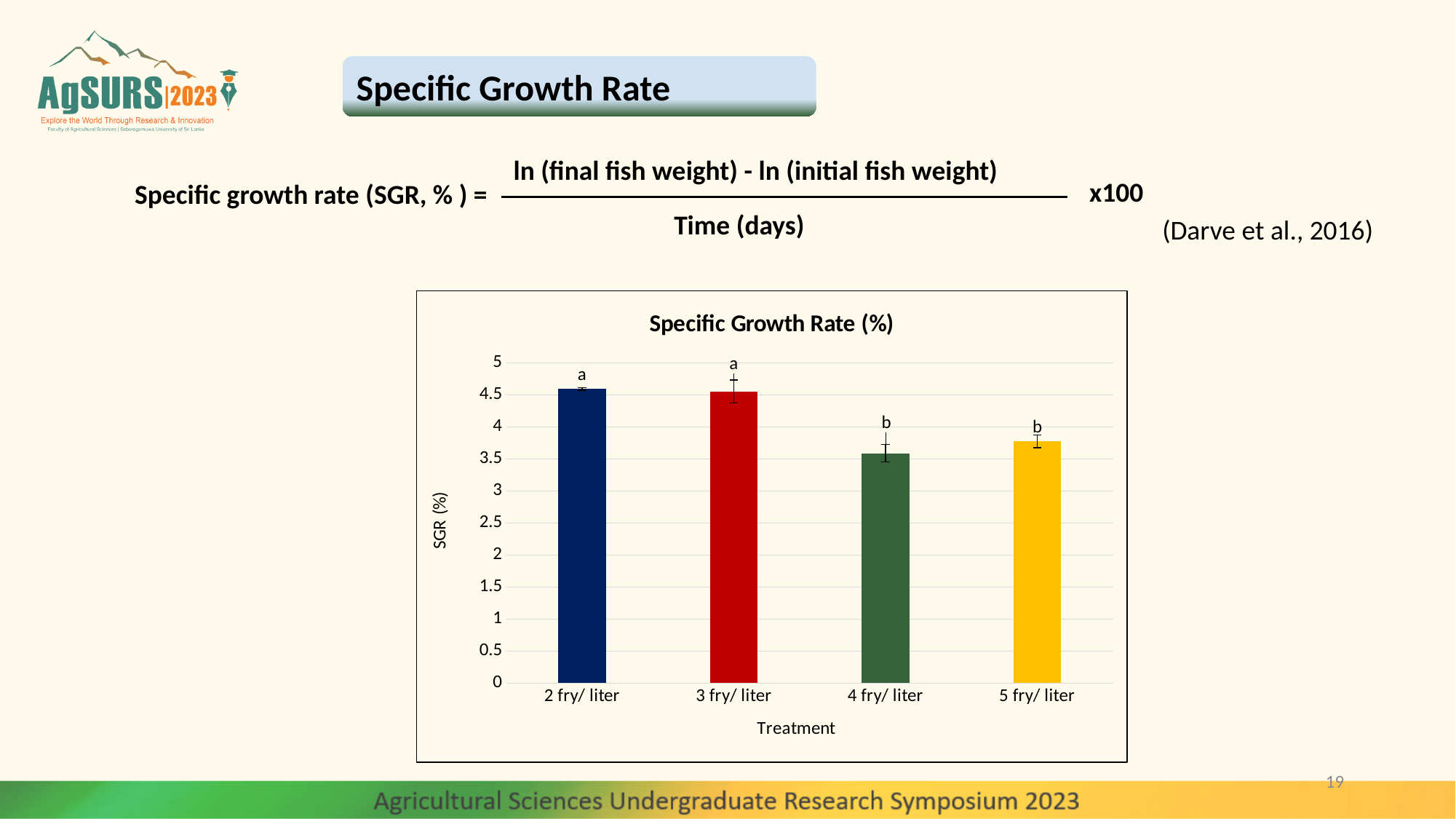
Which treatment has the lowest specific growth rate? 4 fry/ liter Is the value for 3 fry/ liter greater or less than 4? greater How many treatment categories are plotted in the chart? 4 Is the value for 2 fry/ liter greater or less than 4? greater What is the title of the chart? Specific Growth Rate (%) What kind of chart is shown on the slide? bar chart Which is larger, the SGR for 3 fry/ liter or for 5 fry/ liter? 3 fry/ liter Is the value for 5 fry/ liter greater or less than 4? less Which is larger, the SGR for 2 fry/ liter or for 4 fry/ liter? 2 fry/ liter What is the label of the x axis of the chart? Treatment